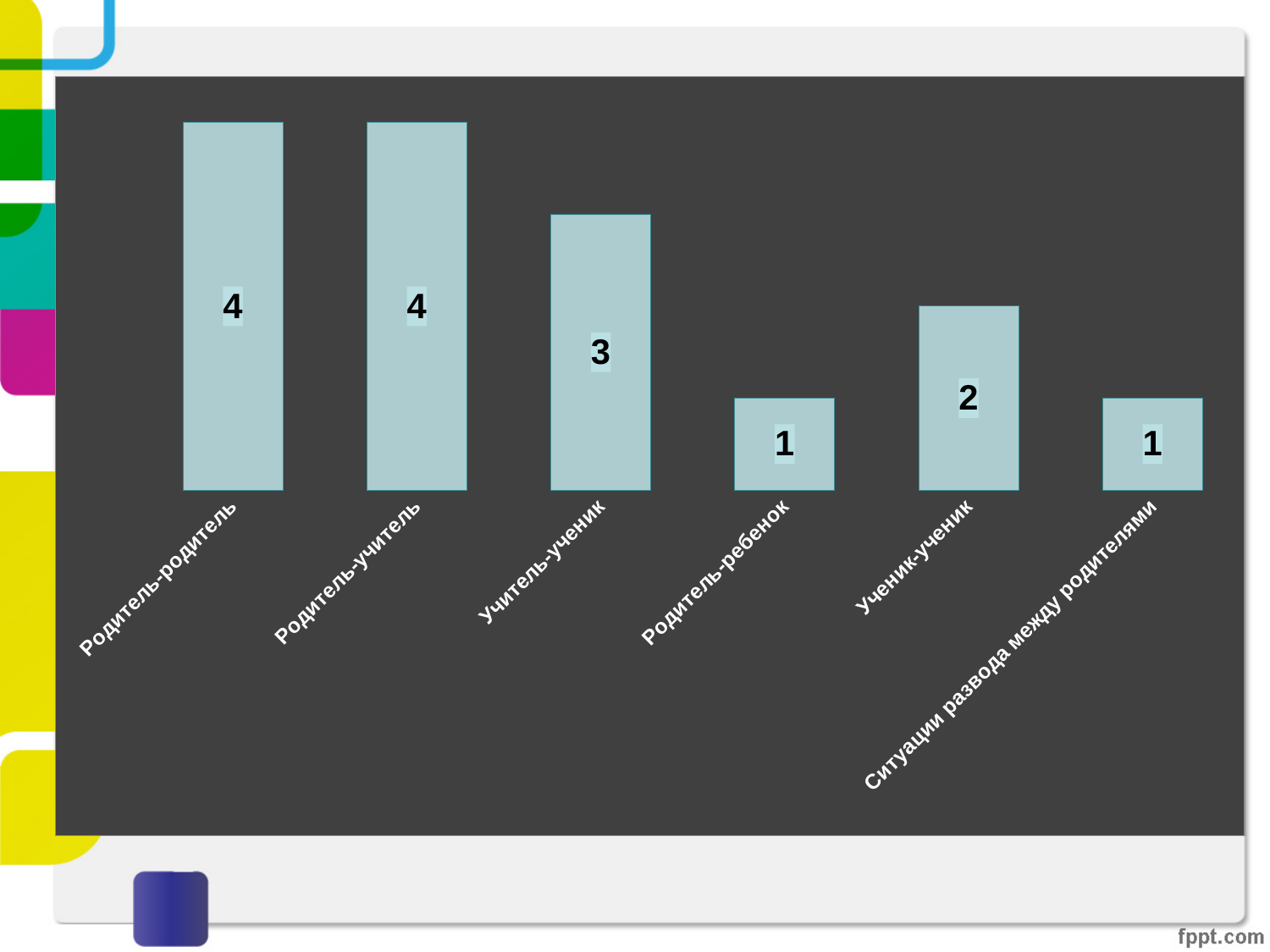
What kind of chart is shown on the slide? Bar chart What is the value for учитель-ученик? 3 Which category has the lowest value, учитель-ученик or Ученик-ученик? Ученик-ученик What is the difference between the values for Родитель-учитель and Ученик-ученик? 2 How many categories are shown in the chart? 6 What is the value for Ситуации развода между родителями? 1 Which is larger, the value for Ученик-ученик or the value for Родитель-ребенок? Ученик-ученик What is the value for Родитель-ребенок? 1 Which is larger, the value for Родитель-учитель or the value for учитель-ученик? Родитель-учитель What is the value for Родитель-родитель? 4 What is the value for Ученик-ученик? 2 What is the difference between the values for учитель-ученик and Родитель-ребенок? 2